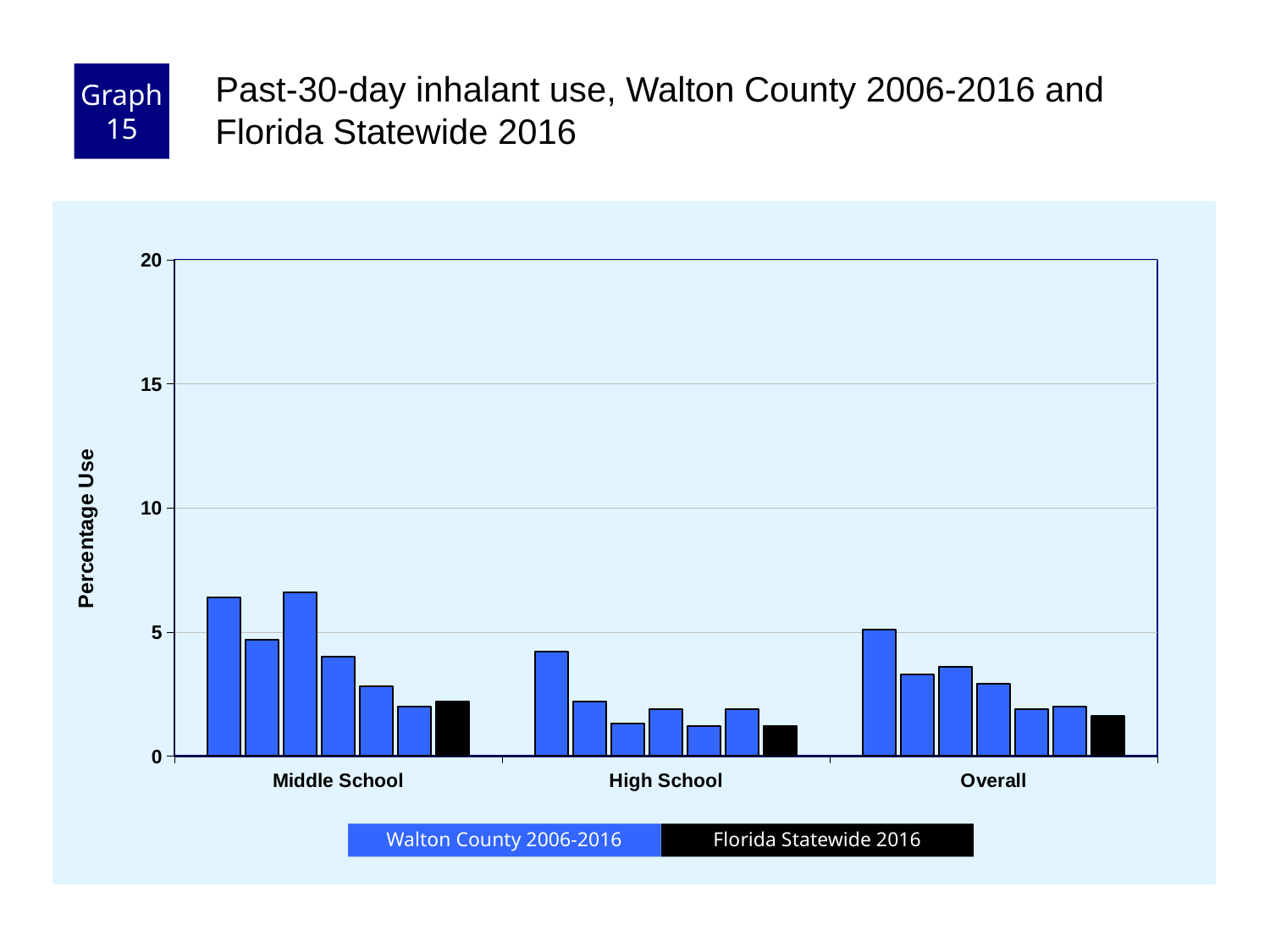
What is the label on the y axis? Percentage Use How many series does the legend list? 2 Is the Florida Statewide 2016 value for Middle School greater or less than 5? less Which category group contains the tallest bar on the chart? Middle School How many Walton County 2006-2016 bars are shown in the Middle School group? 6 Which category group has the highest Florida Statewide 2016 bar? Middle School Is the value of the first Walton County bar in the Middle School group greater or less than 5? greater Is the value of the first Walton County bar in the High School group greater or less than 5? less Which is larger: the Florida Statewide 2016 bar for Middle School or for High School? Middle School What kind of chart is shown on the slide? bar chart Do the Walton County 2006-2016 bars in the Overall group generally rise or fall from left to right? fall How many category groups are shown on the x axis? 3